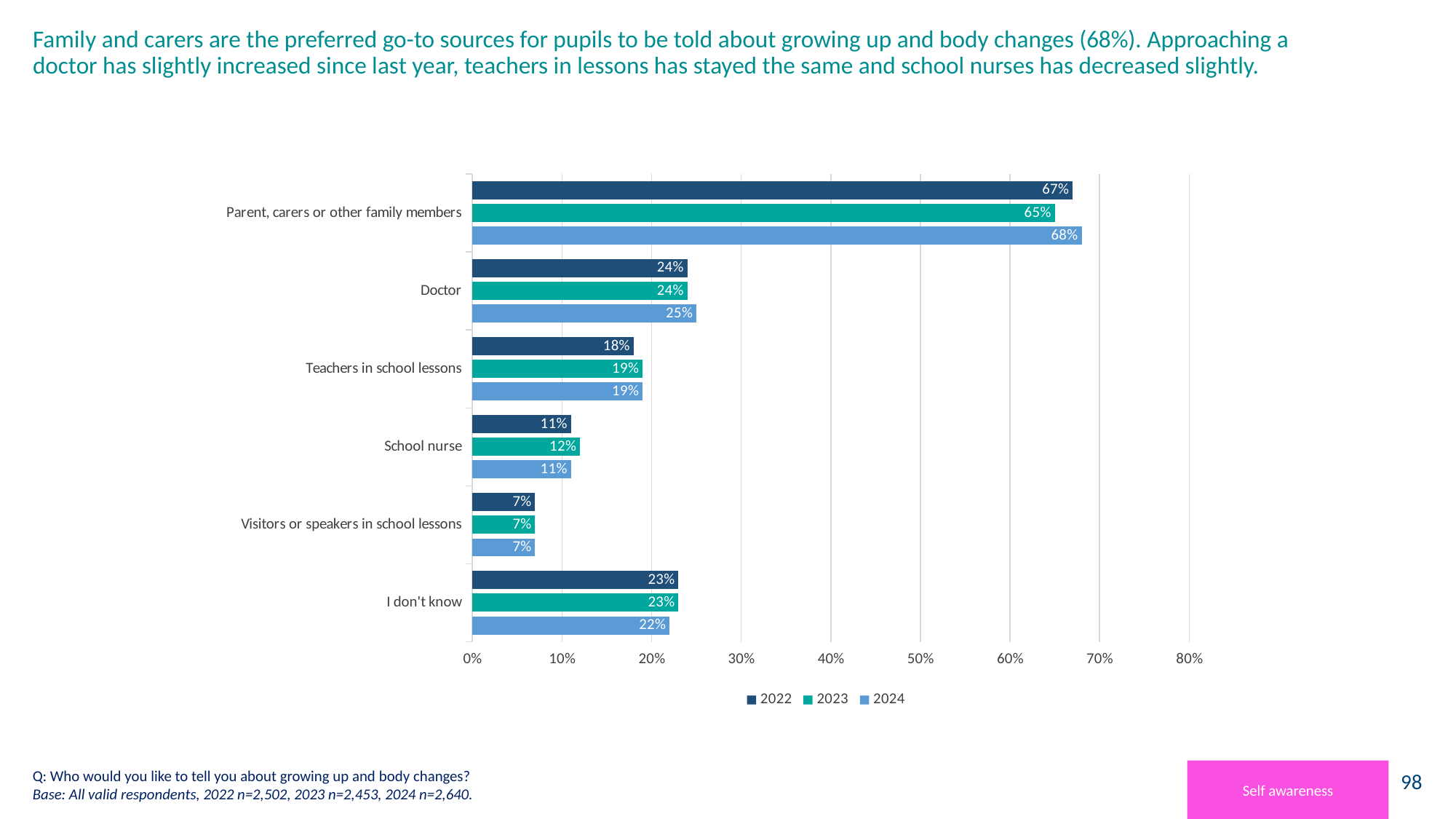
What is the 2023 value for School nurse? 12% Which is larger for 2024: Doctor or I don't know? Doctor What is the difference between the 2024 and 2023 values for Parent, carers or other family members? 3% Which category has the highest value in 2024? Parent, carers or other family members What is the 2024 value for I don't know? 22% How many categories are shown on the chart? 6 Which years are listed in the legend? 2022, 2023, 2024 Which category has the lowest value in 2022? Visitors or speakers in school lessons What is the 2022 value for Doctor? 24% What kind of chart is shown on the slide? Bar chart How many series does the legend list? 3 What is the 2024 value for Parent, carers or other family members? 68%